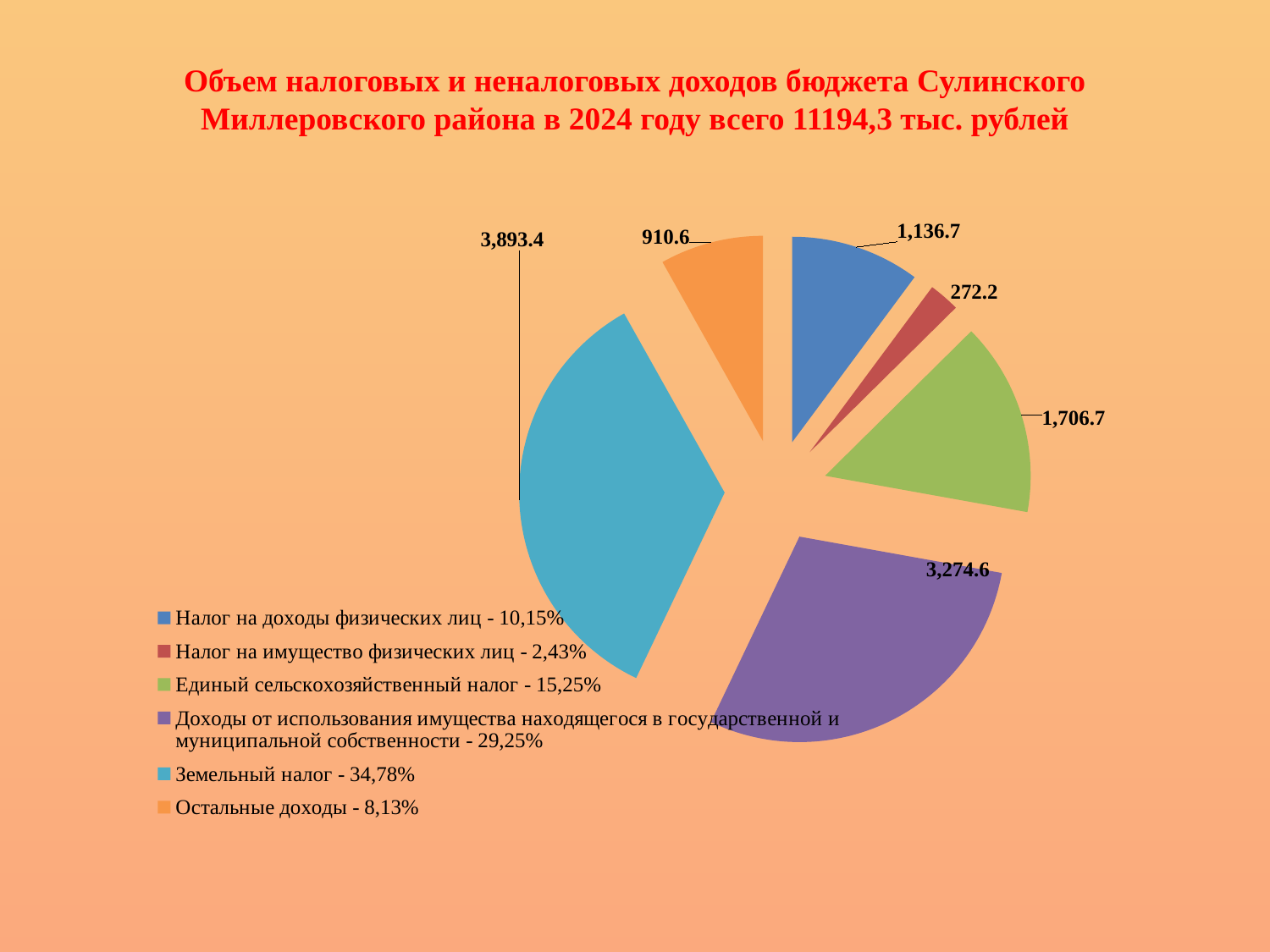
Which category has the smallest slice? Налог на имущество физических лиц What is the value for Единый сельскохозяйственный налог? 1,706.7 What kind of chart is shown on the slide? pie chart What share of the pie does Единый сельскохозяйственный налог represent, according to the legend? 15,25% What colour is the slice for Доходы от использования имущества находящегося в государственной и муниципальной собственности? purple What is the difference between the values for Земельный налог and Доходы от использования имущества находящегося в государственной и муниципальной собственности? 618.8 Which category has the largest slice? Земельный налог What is the value for Налог на имущество физических лиц? 272.2 Which is larger: Налог на доходы физических лиц or Остальные доходы? Налог на доходы физических лиц What is the value for Земельный налог? 3,893.4 What is the value for Остальные доходы? 910.6 How many slices does the pie chart have? 6